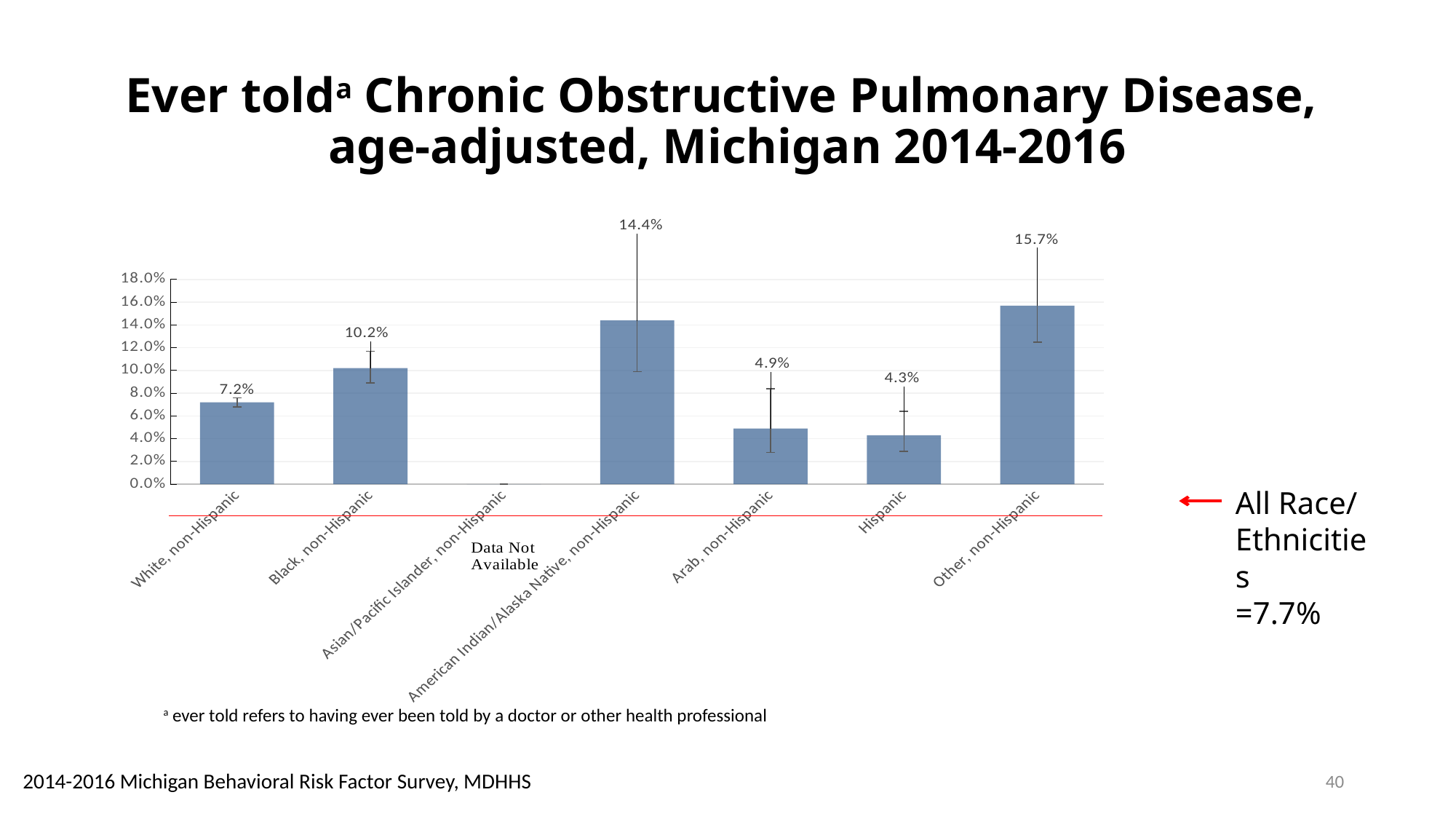
What is the value for Black, non-Hispanic? 10.2% Which category has the highest value? Other, non-Hispanic What is the value for Hispanic? 4.3% Is the value for Arab, non-Hispanic greater or less than 6.0%? less Which is larger, the value for Black, non-Hispanic or the value for Arab, non-Hispanic? Black, non-Hispanic What is the value for American Indian/Alaska Native, non-Hispanic? 14.4% What is the value for White, non-Hispanic? 7.2% Which category is marked as Data Not Available? Asian/Pacific Islander, non-Hispanic What kind of chart is this? bar chart Which category with a plotted bar has the lowest value? Hispanic What is the difference between the values for Other, non-Hispanic and White, non-Hispanic? 8.5% How many categories are shown on the x axis? 7